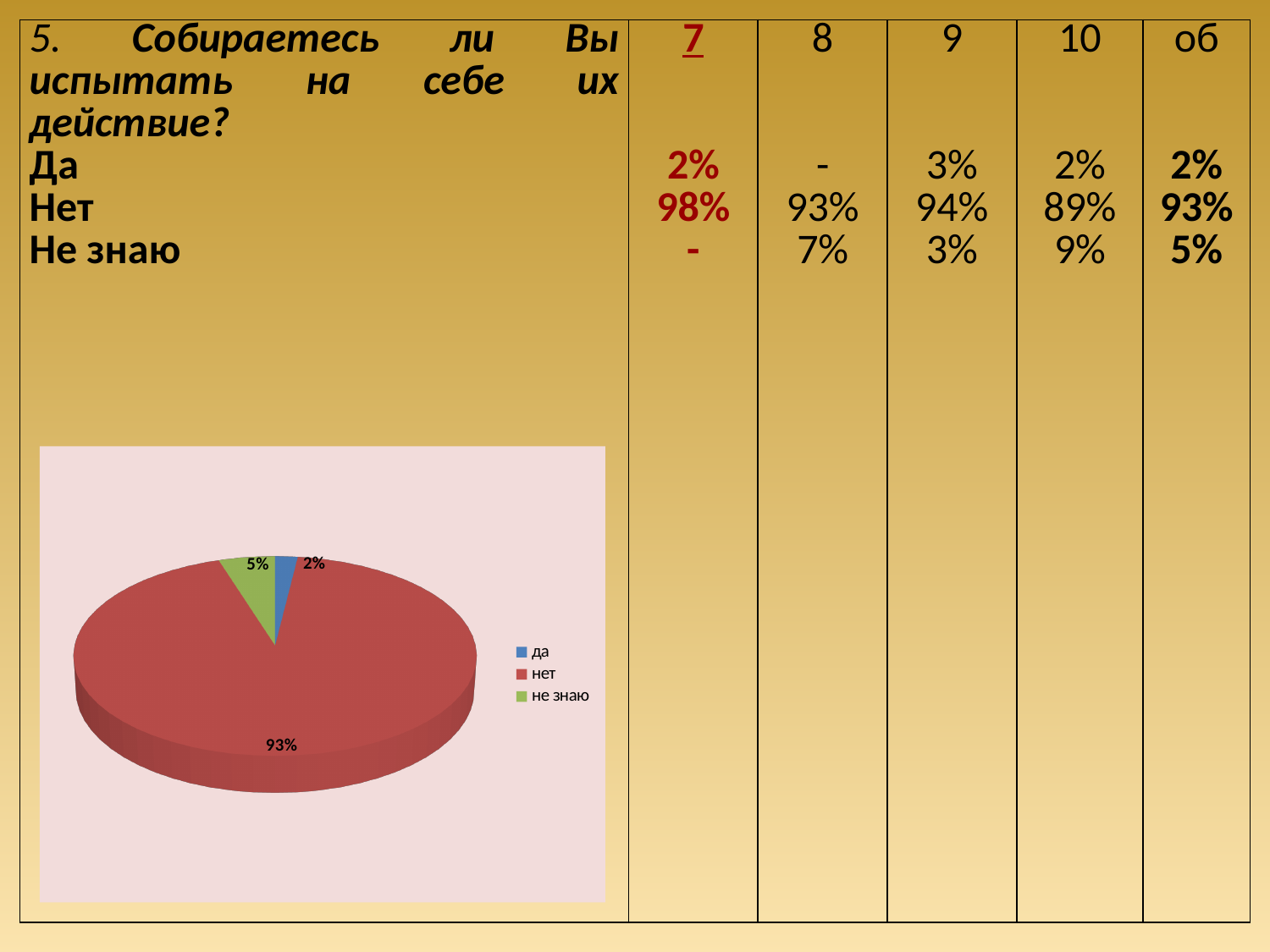
Which slice of the pie chart is the smallest? да Which slice of the pie chart is the largest? нет What colour is the "нет" slice in the pie chart? red How many entries does the legend of the pie chart list? 3 How many slices does the pie chart have? 3 What share of the pie does the "да" slice have? 2% What colour is the "не знаю" slice in the pie chart? green What kind of chart is shown on the slide? pie chart What share of the pie does the "не знаю" slice have? 5% What is the difference between the "нет" slice and the "не знаю" slice? 88% Which is larger in the pie chart, "не знаю" or "да"? не знаю What share of the pie does the "нет" slice have? 93%